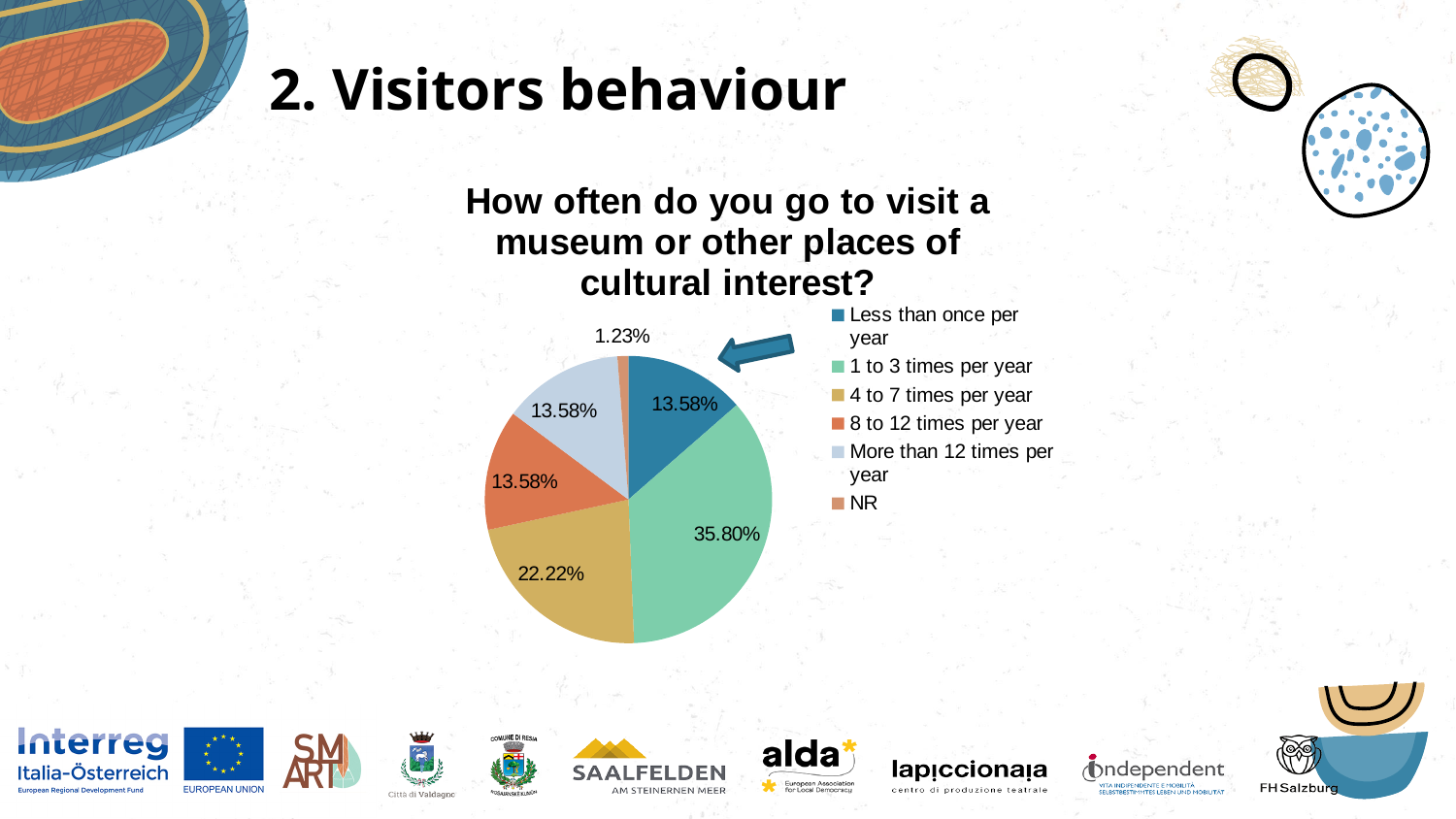
What share of respondents visit a museum 4 to 7 times per year? 22.22% What share of respondents answered NR? 1.23% Which category has the smallest slice of the pie? NR Which category has the largest slice of the pie? 1 to 3 times per year What is the title of the chart? How often do you go to visit a museum or other places of cultural interest? What colour is the slice for 1 to 3 times per year? green What share of respondents visit a museum 1 to 3 times per year? 35.80% What kind of chart is shown on the slide? pie chart Which is larger: the share for 4 to 7 times per year or the share for 8 to 12 times per year? 4 to 7 times per year What is the difference between the share for 1 to 3 times per year and the share for 4 to 7 times per year? 13.58% What share of respondents visit a museum less than once per year? 13.58% How many categories does the legend list? 6